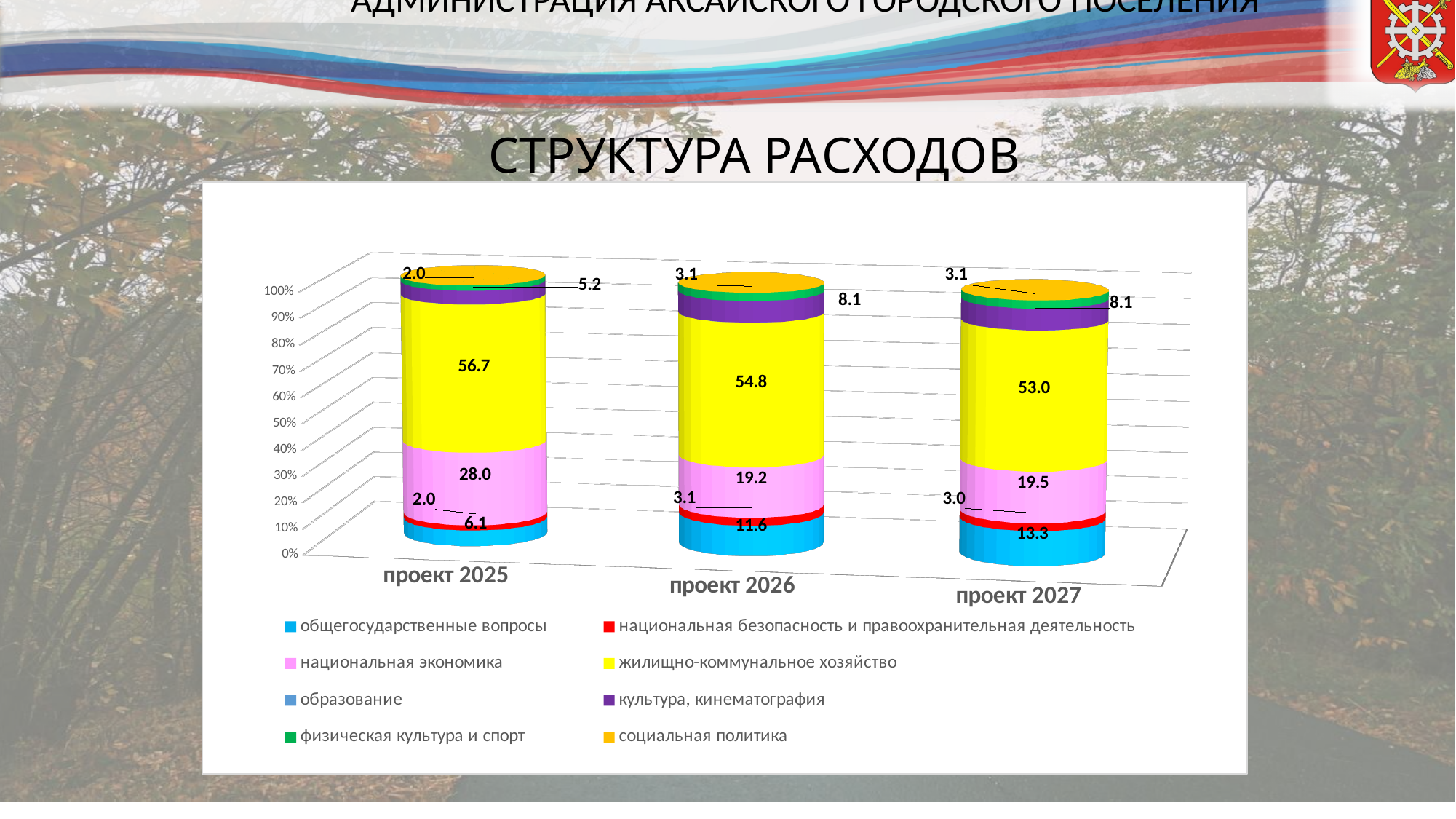
What is the difference between the жилищно-коммунальное хозяйство values for проект 2025 and проект 2027? 3.7 How many series does the legend list? 8 What is the value for национальная экономика in проект 2026? 19.2 How many categories (projects) are shown on the x axis? 3 What is the value for общегосударственные вопросы in проект 2027? 13.3 What kind of chart is shown on the slide? stacked bar chart Does the value for жилищно-коммунальное хозяйство rise or fall from проект 2025 to проект 2027? fall Which is larger: национальная экономика in проект 2025 or in проект 2027? проект 2025 Which project has the highest value for жилищно-коммунальное хозяйство? проект 2025 What is the value for жилищно-коммунальное хозяйство in проект 2025? 56.7 What is the value for культура, кинематография in проект 2026? 8.1 Which project has the lowest value for общегосударственные вопросы? проект 2025